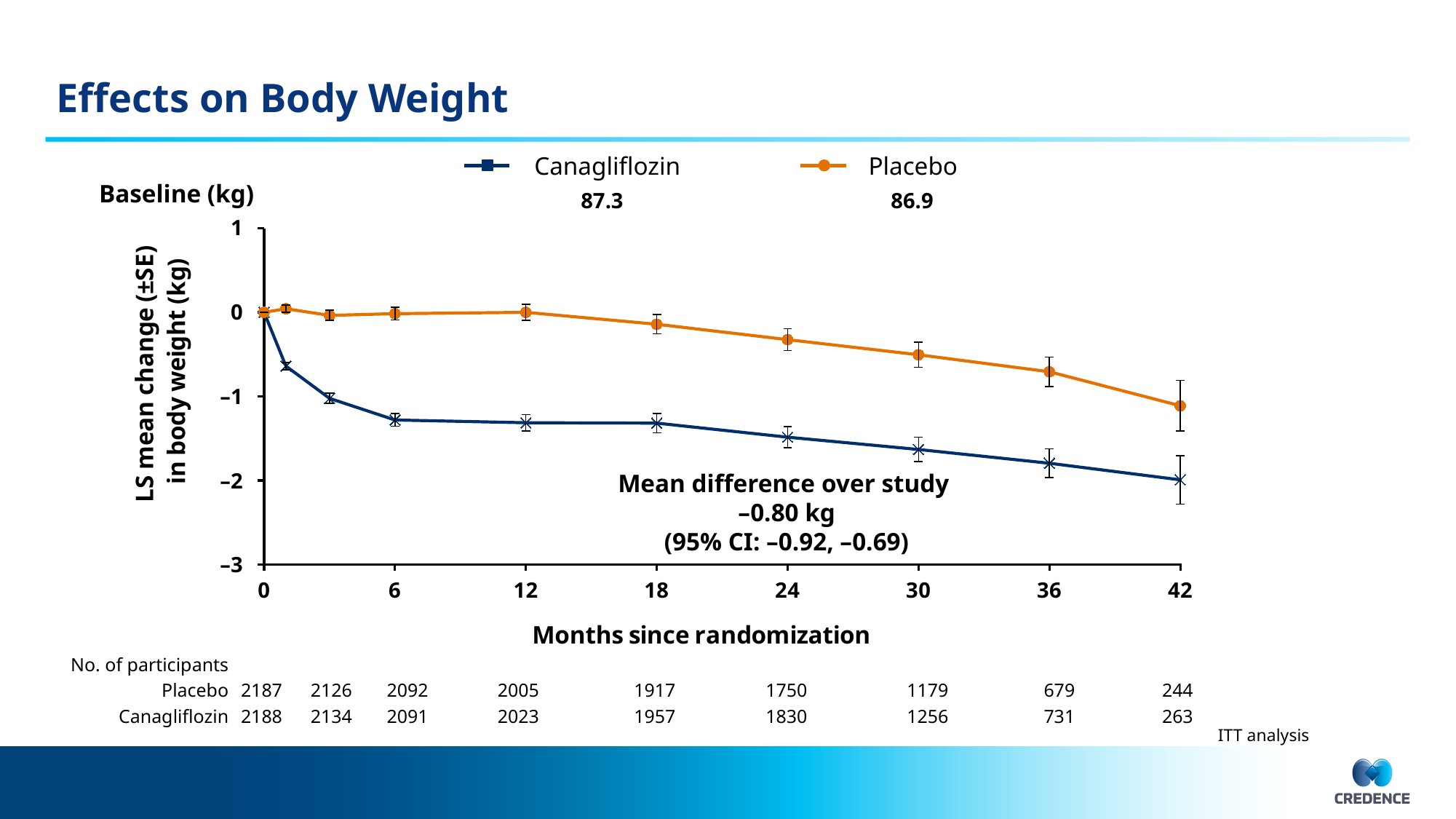
At 24 months, which series has the higher LS mean change in body weight? Placebo How many series does the legend list? 2 What mean difference over the study is printed on the chart? –0.80 kg What is the baseline body weight (kg) shown for Placebo? 86.9 What are the two series named in the legend? Canagliflozin and Placebo What kind of chart is shown on the slide? line chart Is the Canagliflozin value at 42 months greater or less than –1? less How many participants are listed for Placebo at 42 months? 244 What is the difference between the number of Canagliflozin and Placebo participants at 42 months? 19 What is the baseline body weight (kg) shown for Canagliflozin? 87.3 Is the Placebo value at 42 months greater or less than –2? greater Does the Canagliflozin line rise or fall as months since randomization increase? fall